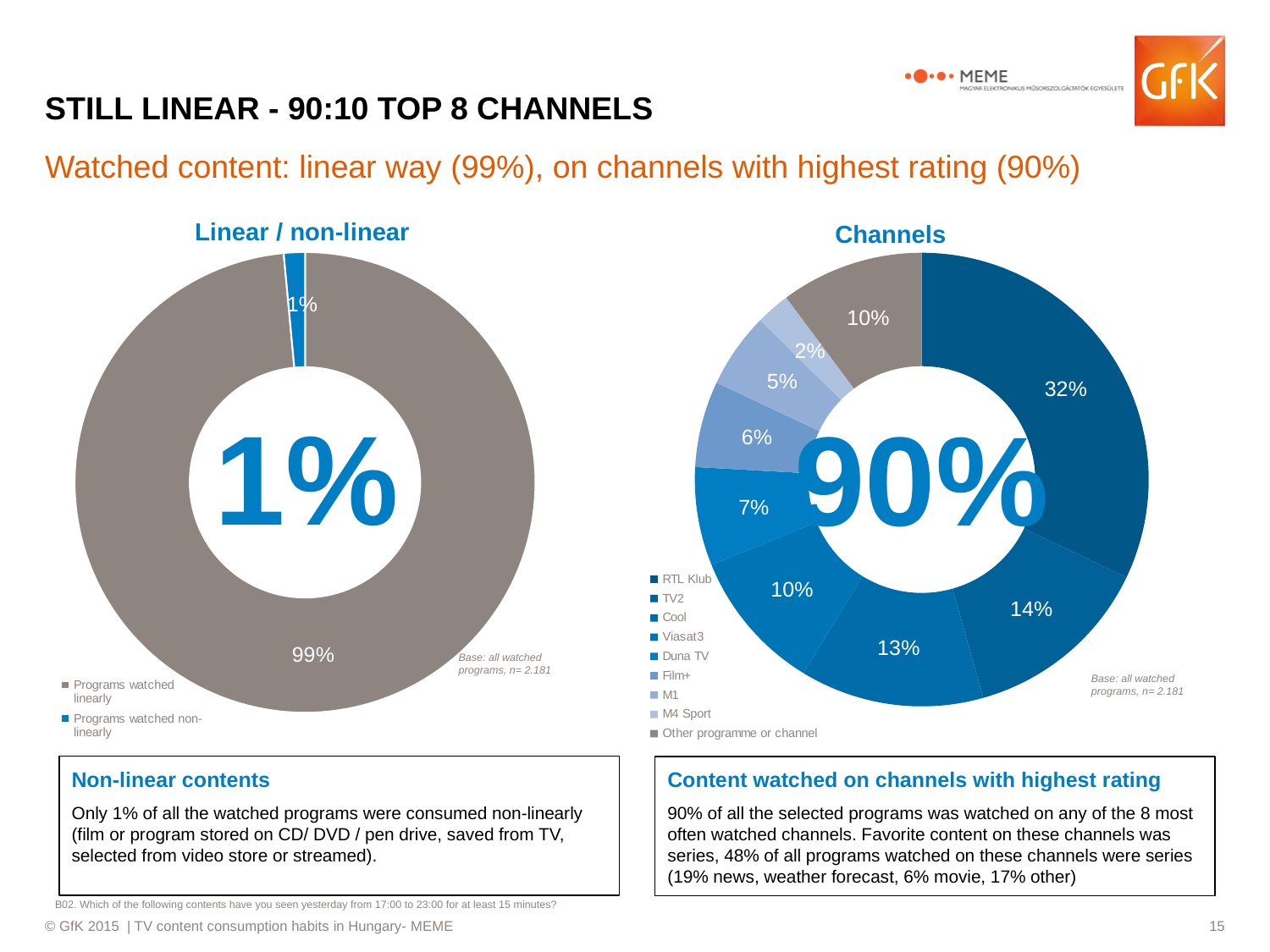
In the 'Channels' chart, what share does TV2 have? 14% What number is printed in the centre of the 'Channels' chart? 90% In the 'Linear / non-linear' chart, what share of programs were watched non-linearly? 1% In the 'Channels' chart, which has a larger share, Cool or Viasat3? Cool In the 'Channels' chart, what share does RTL Klub have? 32% How many entries does the legend of the 'Channels' chart list? 9 In the 'Channels' chart, which channel has the largest share? RTL Klub What kind of chart is the 'Linear / non-linear' chart? Doughnut (pie) chart In the 'Channels' chart, which channel has the smallest share? M4 Sport In the 'Channels' chart, what is the difference between the shares of RTL Klub and TV2? 18% How many entries does the legend of the 'Linear / non-linear' chart list? 2 In the 'Linear / non-linear' chart, what share of programs were watched linearly? 99%